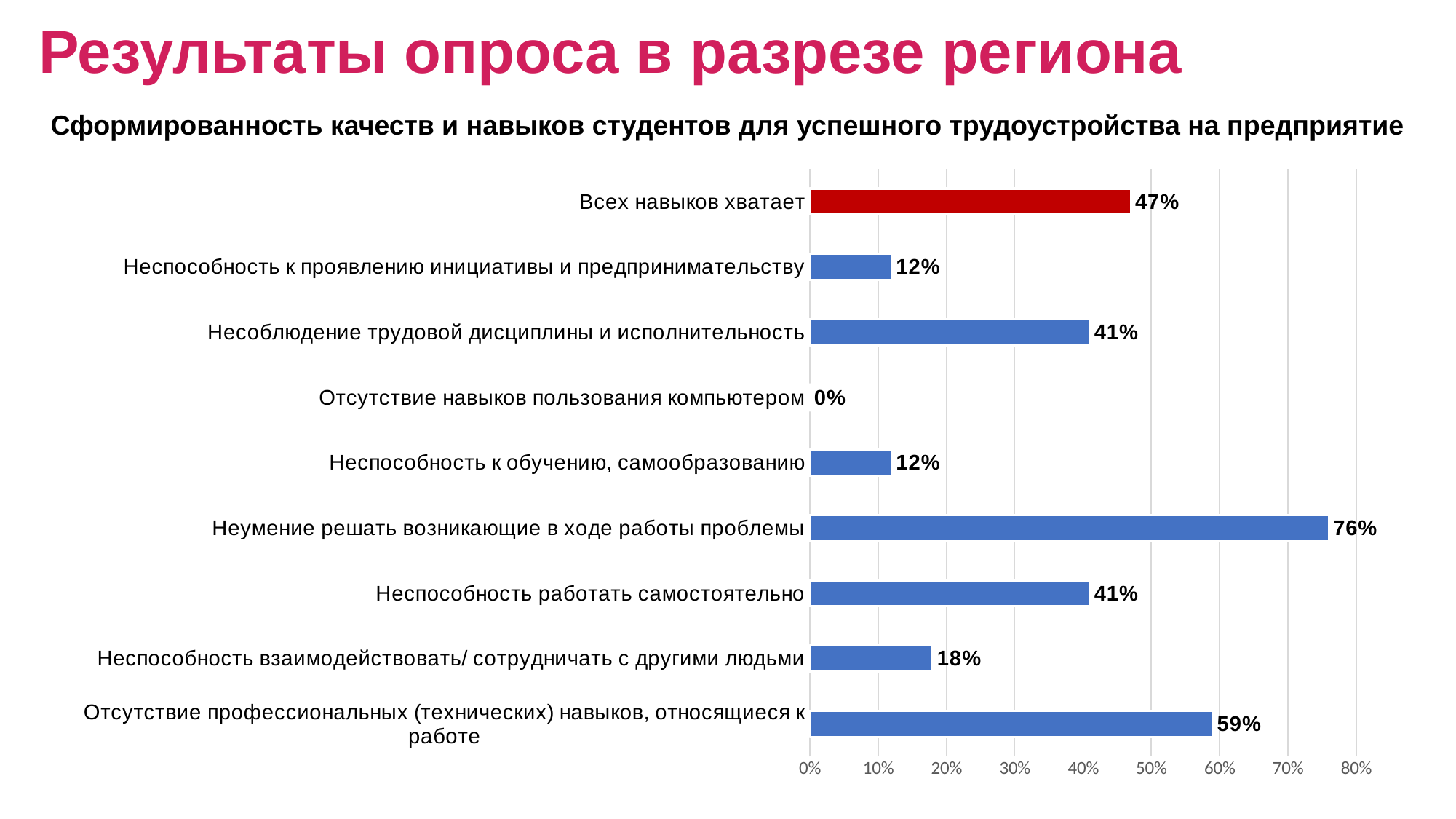
How many categories are shown in the chart? 9 What is the value for "Неумение решать возникающие в ходе работы проблемы"? 76% Which category has the lowest value? Отсутствие навыков пользования компьютером Which is larger: the value for "Всех навыков хватает" or the value for "Несоблюдение трудовой дисциплины и исполнительность"? Всех навыков хватает Which category has the highest value? Неумение решать возникающие в ходе работы проблемы What is the value for "Отсутствие профессиональных (технических) навыков, относящиеся к работе"? 59% What kind of chart is shown on the slide? Bar chart What is the difference between the values for "Неумение решать возникающие в ходе работы проблемы" and "Отсутствие профессиональных (технических) навыков, относящиеся к работе"? 17% What is the value for "Всех навыков хватает"? 47% Which bar is coloured red rather than blue? Всех навыков хватает What is the value for "Неспособность взаимодействовать/ сотрудничать с другими людьми"? 18% What is the difference between the values for "Всех навыков хватает" and "Неспособность к проявлению инициативы и предпринимательству"? 35%